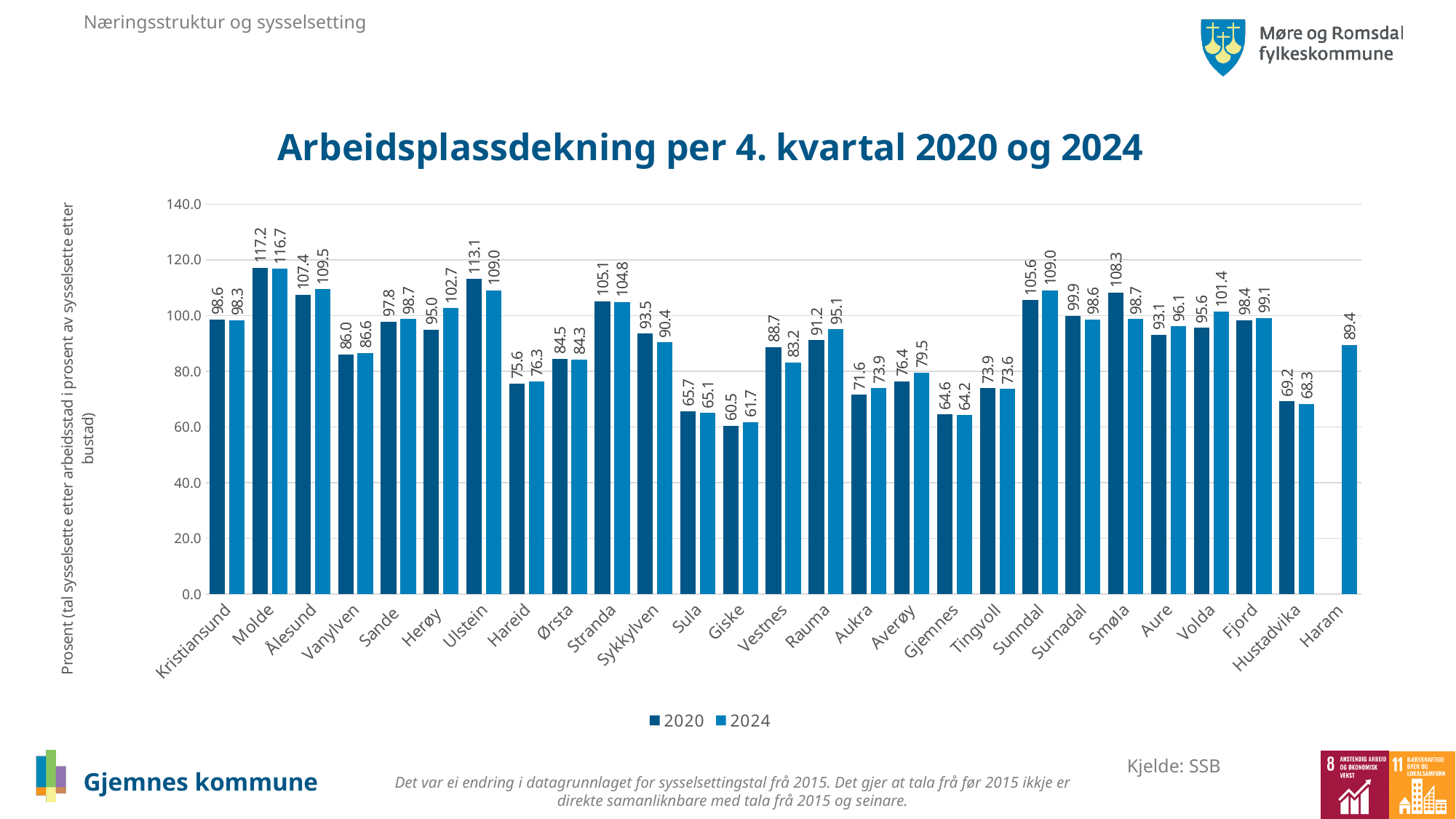
What kind of chart is shown on the slide? Bar chart How many series does the legend list? 2 What is the 2024 value for Haram? 89.4 Is the 2024 value for Sunndal greater or less than 100.0? greater What is the 2020 value for Molde? 117.2 What is the difference between the 2024 and 2020 values for Herøy? 7.7 Which municipality has the lowest 2024 value? Giske How many municipalities are shown on the x axis? 27 Which is larger for Ulstein, the 2020 value or the 2024 value? 2020 Which municipality has the highest 2020 value? Molde What is the 2024 value for Gjemnes? 64.2 What is the difference between the 2020 and 2024 values for Smøla? 9.6